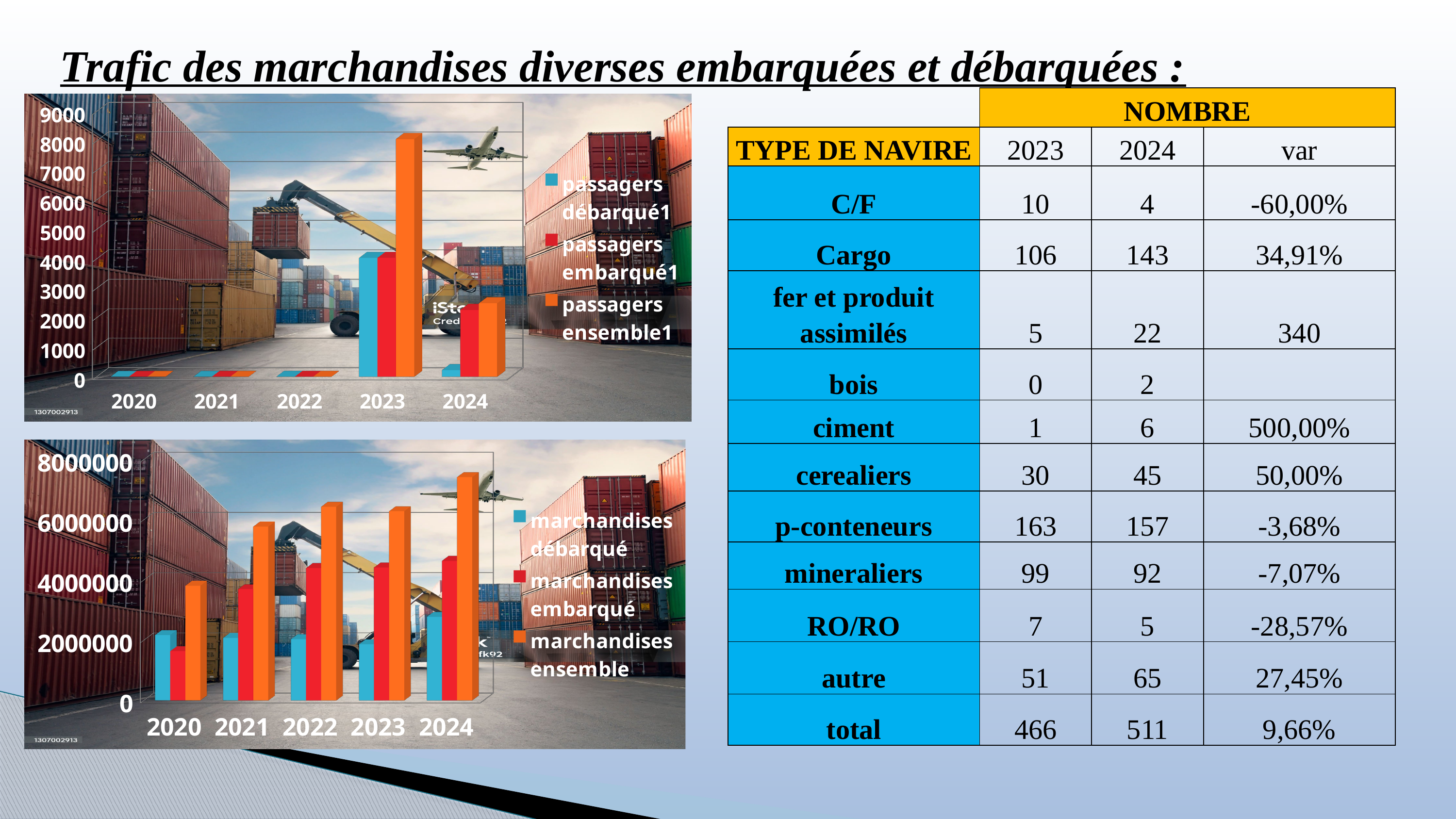
How many series does the legend of the bottom chart list? 3 In the bottom chart, which is larger in 2024: marchandises embarqué or marchandises débarqué? marchandises embarqué What is the first legend entry of the top chart? passagers débarqué1 In the bottom chart, which year has the lowest value for marchandises ensemble? 2020 What kind of chart is the top chart on the slide? bar chart In the top chart, is the value for passagers ensemble1 in 2023 greater or less than 7000? greater How many series does the legend of the top chart list? 3 In the top chart, which year has the highest value for passagers ensemble1? 2023 In the bottom chart, which year has the highest value for marchandises ensemble? 2024 In the bottom chart, is the value for marchandises ensemble in 2020 greater or less than 2000000? greater How many years are shown on the x axis of the top chart? 5 In the top chart, is the value for passagers ensemble1 in 2024 greater or less than 4000? less